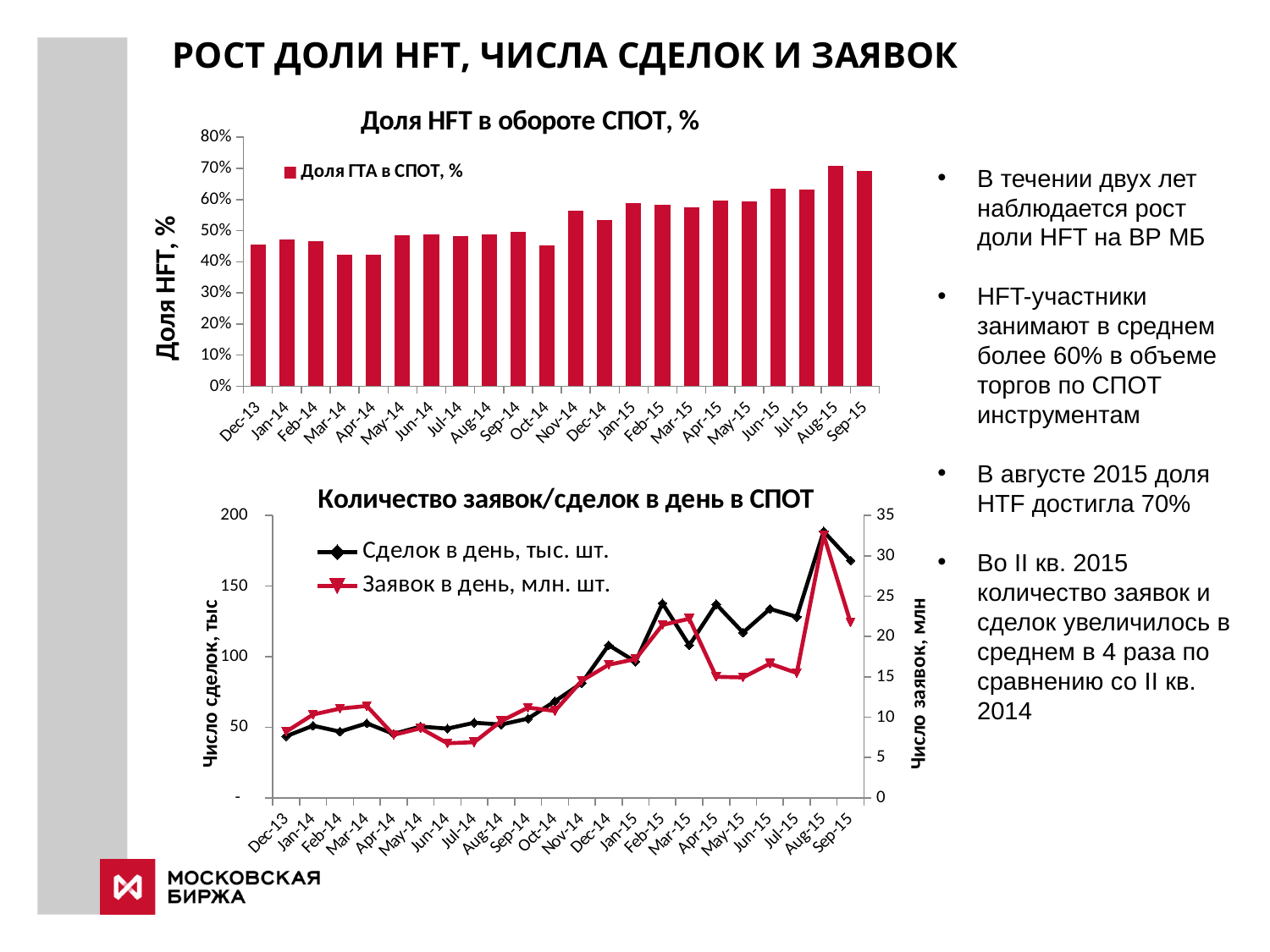
In the top chart 'Доля HFT в обороте СПОТ, %', is the value for Oct-14 greater or less than 50%? less In the bottom chart 'Количество заявок/сделок в день в СПОТ', how many series does the legend list? 2 In the top chart 'Доля HFT в обороте СПОТ, %', which is larger, the value for Dec-13 or the value for Sep-15? Sep-15 In the top chart 'Доля HFT в обороте СПОТ, %', how many months are shown on the x axis? 22 In the top chart 'Доля HFT в обороте СПОТ, %', is the value for Dec-13 greater or less than 50%? less In the bottom chart 'Количество заявок/сделок в день в СПОТ', is the value of 'Сделок в день, тыс. шт.' for Aug-15 greater or less than 150? greater What kind of chart is the bottom chart titled 'Количество заявок/сделок в день в СПОТ'? line chart In the top chart 'Доля HFT в обороте СПОТ, %', which month has the highest bar? Aug-15 In the top chart 'Доля HFT в обороте СПОТ, %', do the values generally rise or fall from Dec-13 to Sep-15? rise In the bottom chart 'Количество заявок/сделок в день в СПОТ', in which month does the series 'Сделок в день, тыс. шт.' reach its highest point? Aug-15 What kind of chart is the top chart titled 'Доля HFT в обороте СПОТ, %'? bar chart